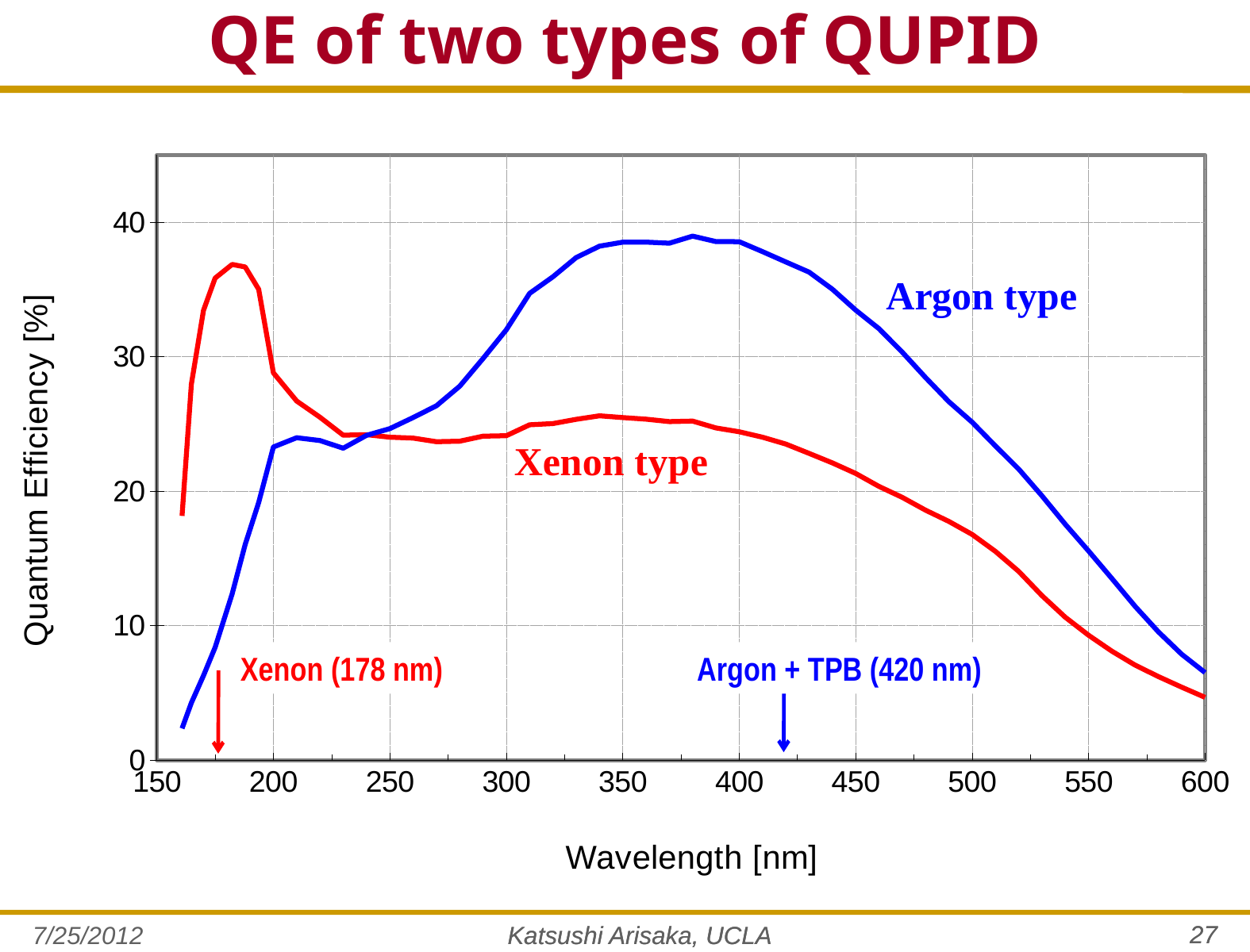
What is the title of the chart on the slide? QE of two types of QUPID What wavelength is marked by the blue arrow labelled Argon + TPB? 420 nm Is the quantum efficiency of the Xenon type at 300 nm greater or less than 20%? greater Does the Argon type curve rise or fall as wavelength increases from 400 nm to 600 nm? fall What kind of chart is shown on the slide? Line chart Is the quantum efficiency of the Xenon type at 400 nm greater or less than 30%? less Which curve has the higher quantum efficiency at 400 nm, Argon type or Xenon type? Argon type Is the quantum efficiency of the Argon type at 400 nm greater or less than 30%? greater Does the Xenon type curve rise or fall as wavelength increases from 450 nm to 600 nm? fall How many series (curves) are plotted on the chart? 2 Which curve has the higher quantum efficiency at 180 nm, Argon type or Xenon type? Xenon type